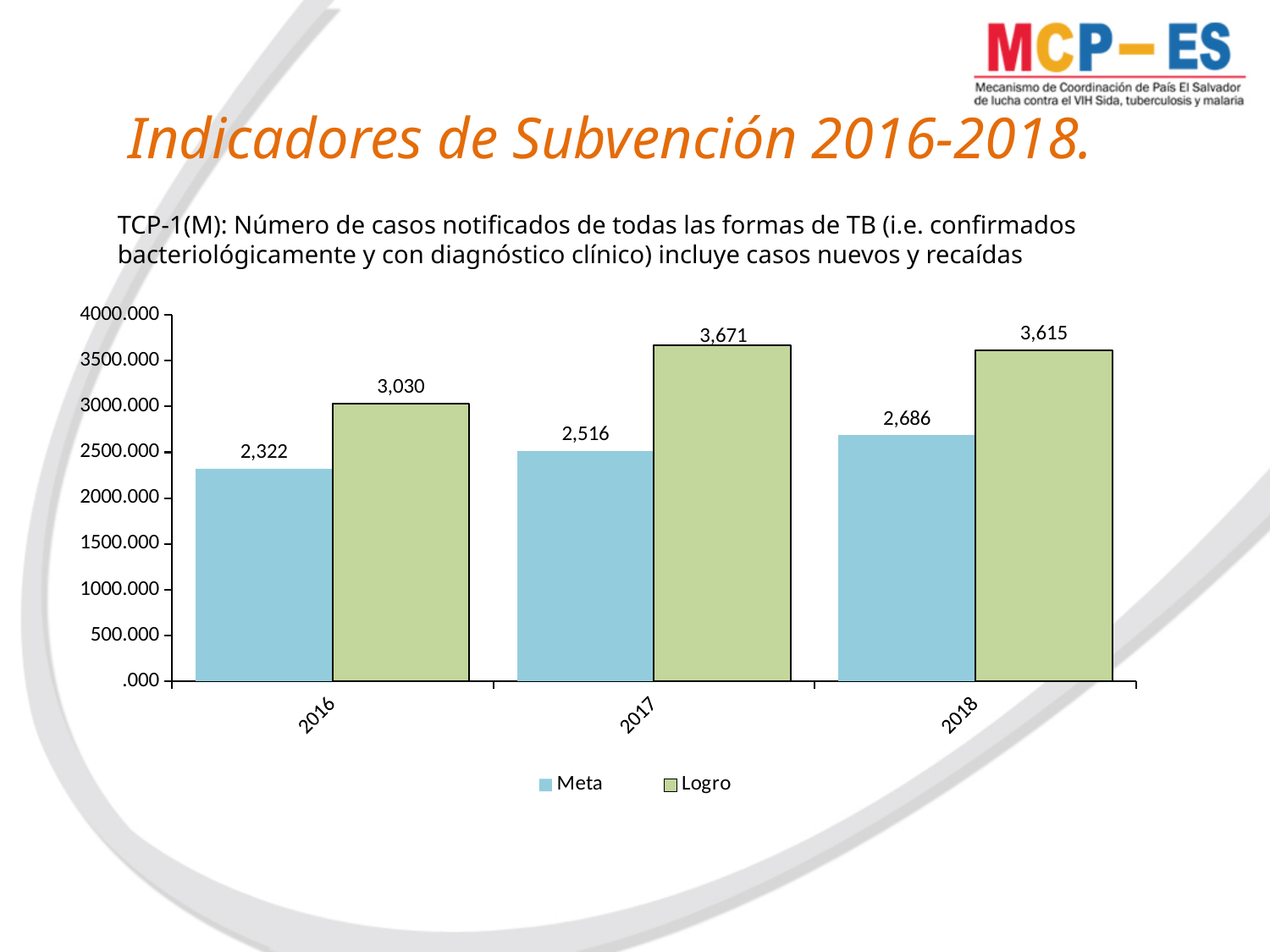
What kind of chart is shown on the slide? bar chart How many series does the legend list? 2 What is the Meta value for 2018? 2,686 What is the Logro value for 2018? 3,615 Is the Logro value for 2016 greater or less than 3500.000? less In which year is the Logro value highest? 2017 In which year is the Meta value lowest? 2016 What is the Meta value for 2016? 2,322 What is the Logro value for 2017? 3,671 Which is larger in 2016, Meta or Logro? Logro What is the difference between Logro and Meta in 2017? 1,155 How many years are shown on the x axis? 3